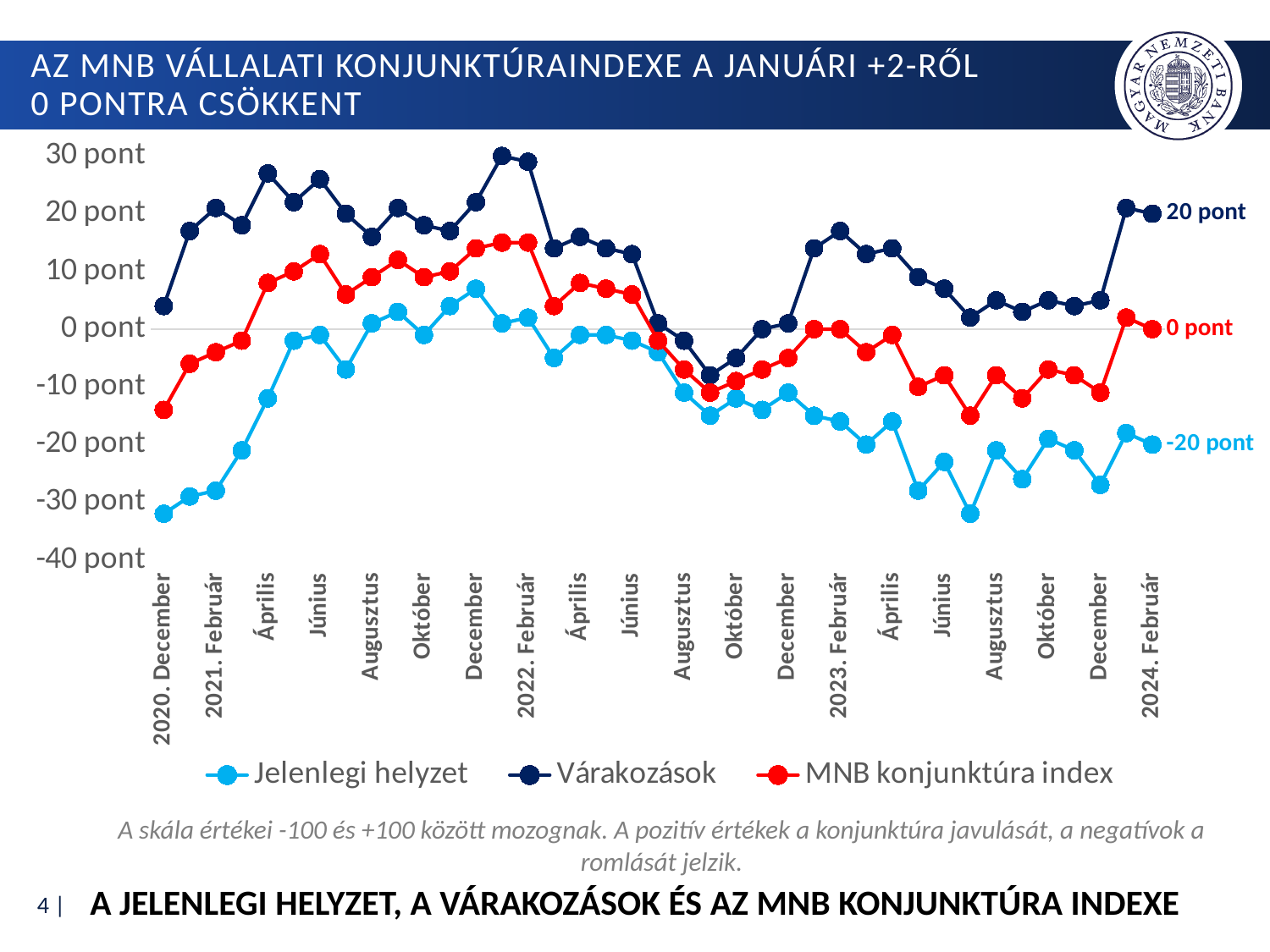
What is the value of Jelenlegi helyzet in 2024. Február? -20 pont What is the value of the MNB konjunktúra index in 2024. Február? 0 pont Which series has the highest value in 2024. Február? Várakozások What is the difference between Várakozások and Jelenlegi helyzet in 2024. Február? 40 pont Is the value of Jelenlegi helyzet in 2020. December greater or less than -30 pont? less What kind of chart is shown on the slide? line chart Is the value of Várakozások in 2022. Február greater or less than 20 pont? greater Does the Jelenlegi helyzet series rise or fall from 2020. December to 2021. Június? rise Which series has the lowest value in 2020. December? Jelenlegi helyzet How many series does the legend list? 3 What is the value of Várakozások in 2024. Február? 20 pont Which series is drawn in red? MNB konjunktúra index